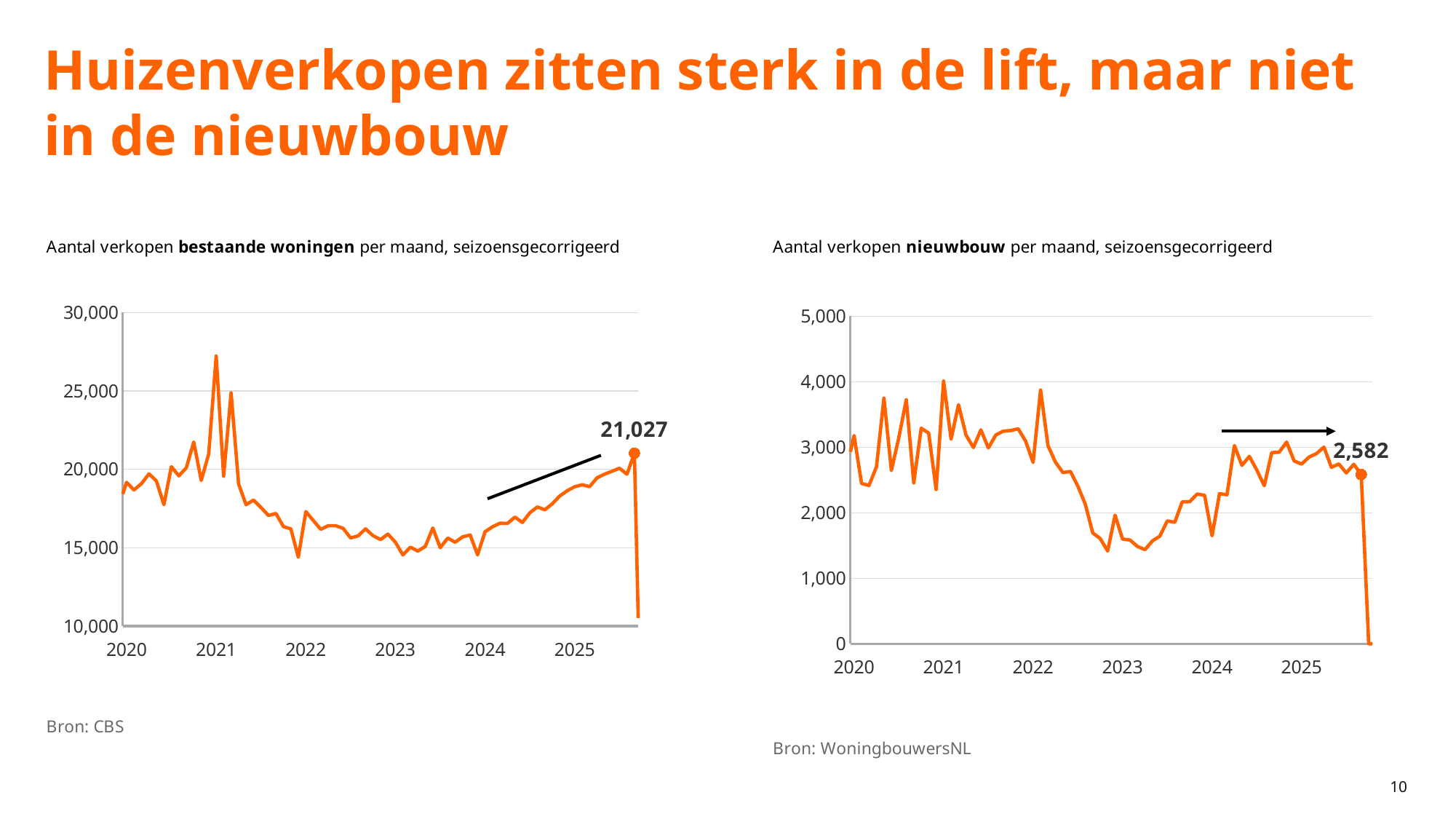
How many year labels are shown on the x axis of the right chart (nieuwbouw)? 6 On the right chart (nieuwbouw), what is the value shown at the latest data point? 2,582 On the left chart (bestaande woningen), do the values rise or fall from 2024 to 2025? rise On the left chart (bestaande woningen), do the values rise or fall from early 2021 to 2023? fall On the left chart (bestaande woningen), is the peak value in early 2021 greater or less than 25,000? greater On the right chart (nieuwbouw), is the lowest value during 2023 greater or less than 2,000? less Which labelled latest value is larger: the one on the bestaande woningen chart or the one on the nieuwbouw chart? Bestaande woningen (21,027) What kind of chart is used on the left side of the slide for bestaande woningen? Line chart What is the difference between the labelled latest value on the left chart (21,027) and the labelled latest value on the right chart (2,582)? 18,445 On the left chart (bestaande woningen), what is the value shown at the latest data point? 21,027 What source is cited below the right chart (nieuwbouw)? WoningbouwersNL On the right chart (nieuwbouw), is the peak value in early 2022 greater or less than 3,000? greater